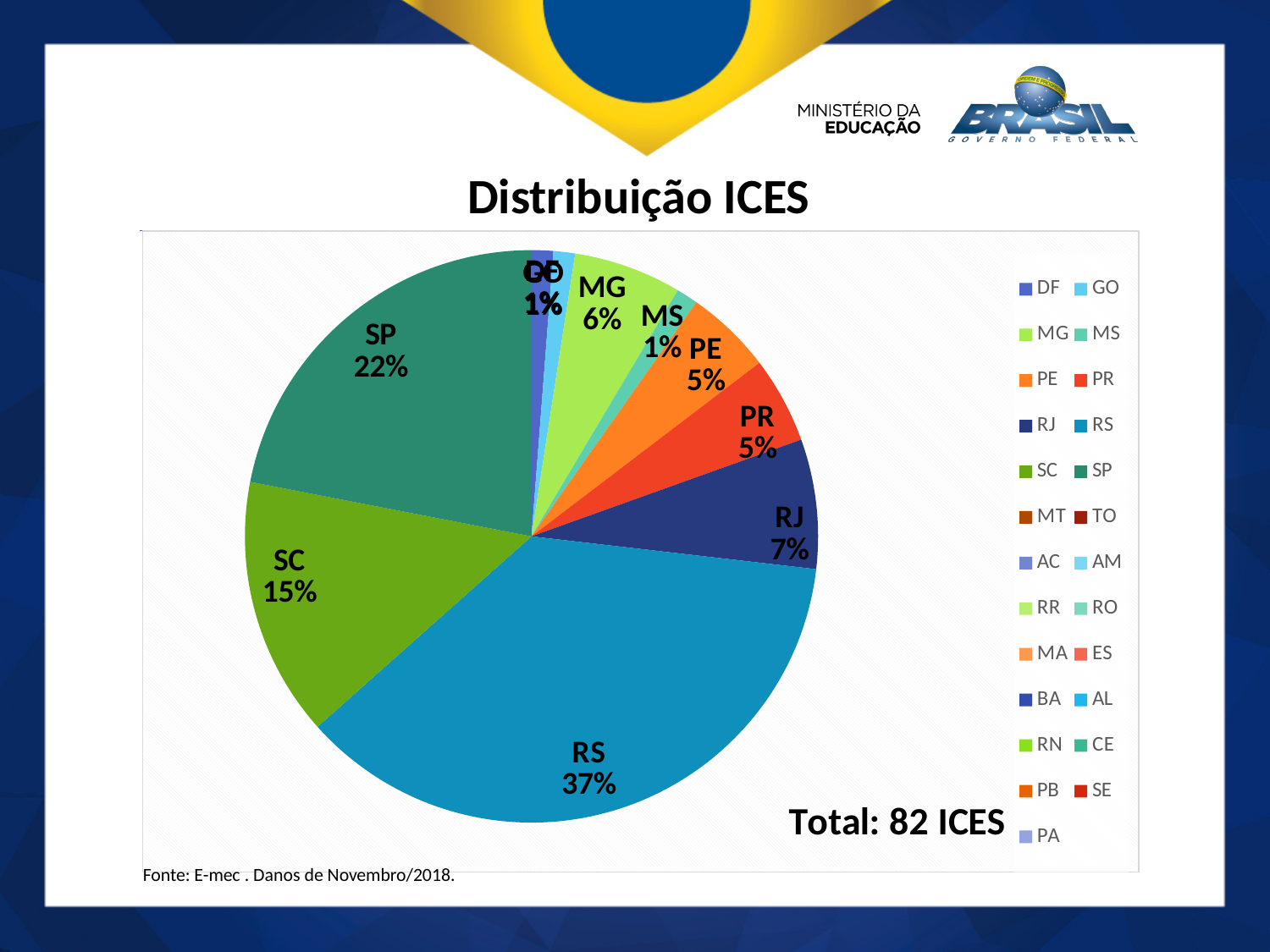
Which is larger, the share for SP or the share for SC? SP What is the title of the chart? Distribuição ICES What total number of ICES is stated on the chart? 82 ICES What share of the pie does SC have? 15% Which state has the largest share of the pie? RS What share of the pie does RJ have? 7% What is the difference in percentage points between the shares of SP and SC? 7 percentage points What share of the pie does SP have? 22% What kind of chart is shown on the slide? pie chart